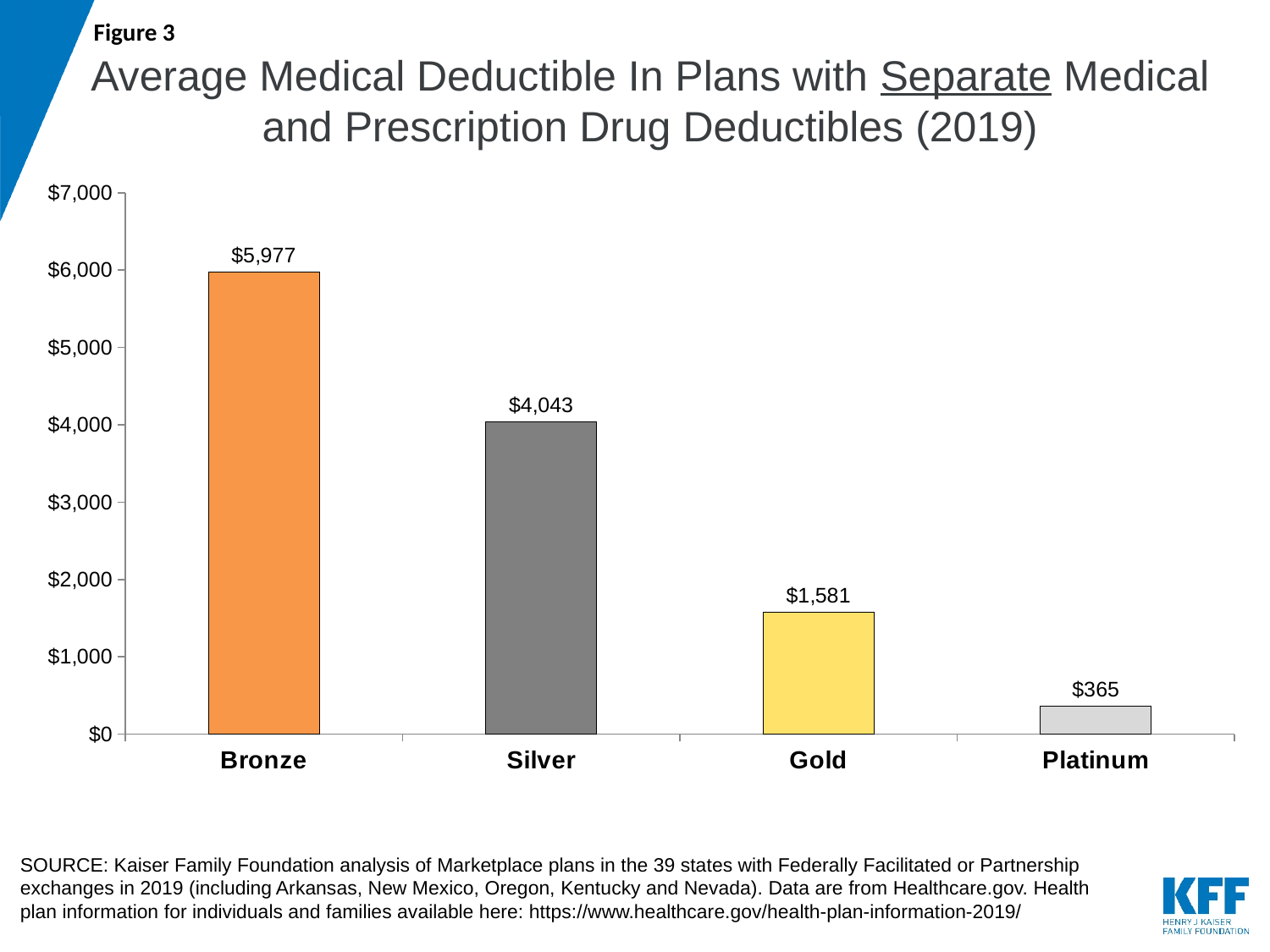
How many plan tiers are shown on the chart? 4 What is the average medical deductible for Gold plans? $1,581 What kind of chart is shown on the slide? Bar chart What is the average medical deductible for Platinum plans? $365 Which plan tier has the highest average medical deductible? Bronze What is the average medical deductible for Bronze plans? $5,977 Which has a larger average medical deductible, Silver or Gold? Silver What is the average medical deductible for Silver plans? $4,043 Do the values rise or fall moving from Bronze to Platinum along the x axis? Fall Which plan tier has the lowest average medical deductible? Platinum What is the difference between the Bronze and Silver average medical deductibles? $1,934 What is the difference between the Gold and Platinum average medical deductibles? $1,216